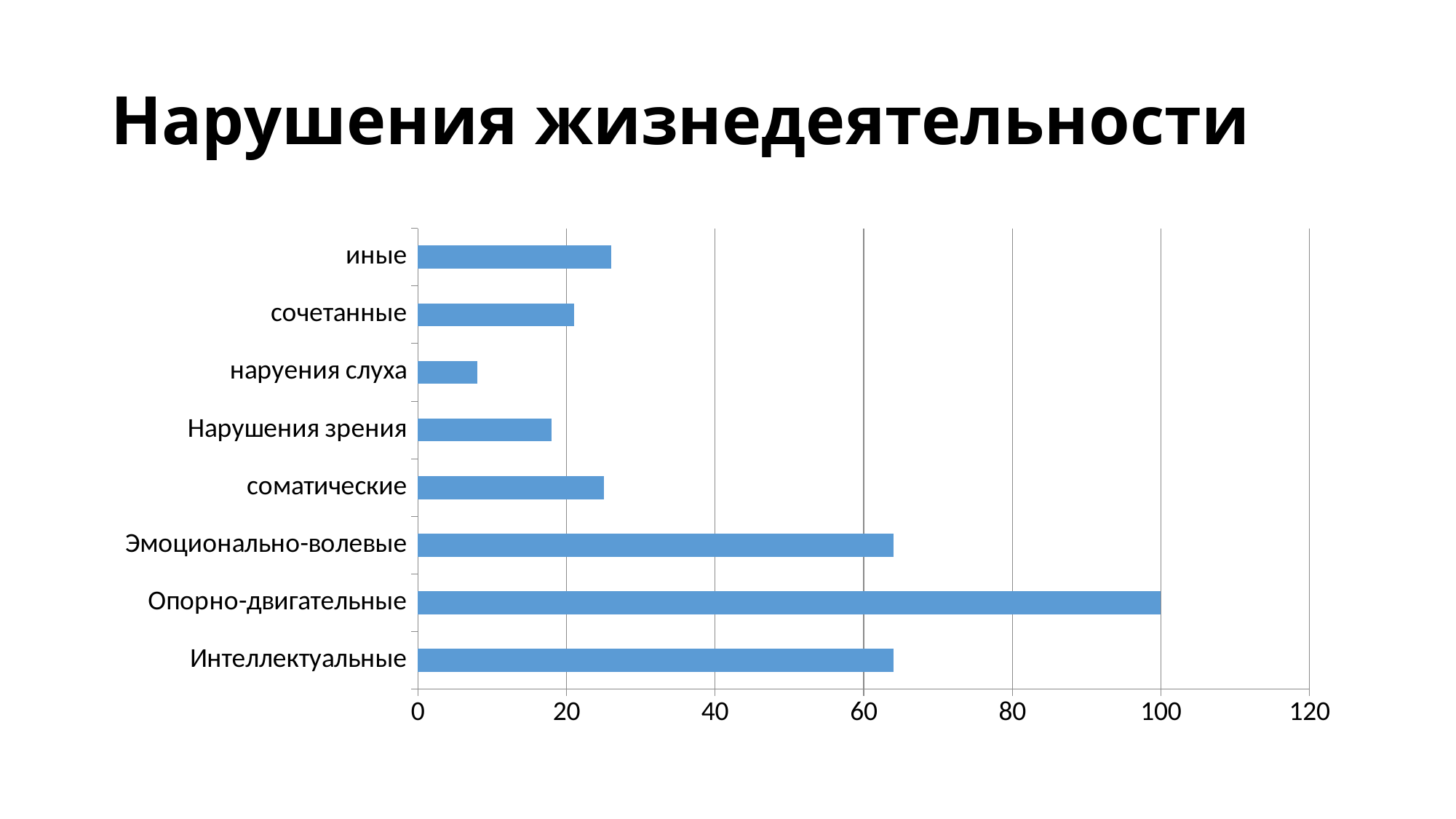
How many categories are plotted in the chart? 8 Which is larger, the value for иные or the value for наруения слуха? иные Is the value for Эмоционально-волевые greater or less than 60? greater Is the value for наруения слуха greater or less than 20? less What is the title of the slide? Нарушения жизнедеятельности Which category has the highest value? Опорно-двигательные What kind of chart is shown on the slide? bar chart Which is larger, the value for Интеллектуальные or the value for соматические? Интеллектуальные Is the value for Нарушения зрения greater or less than 20? less What is the value for Опорно-двигательные? 100 Which category has the lowest value? наруения слуха